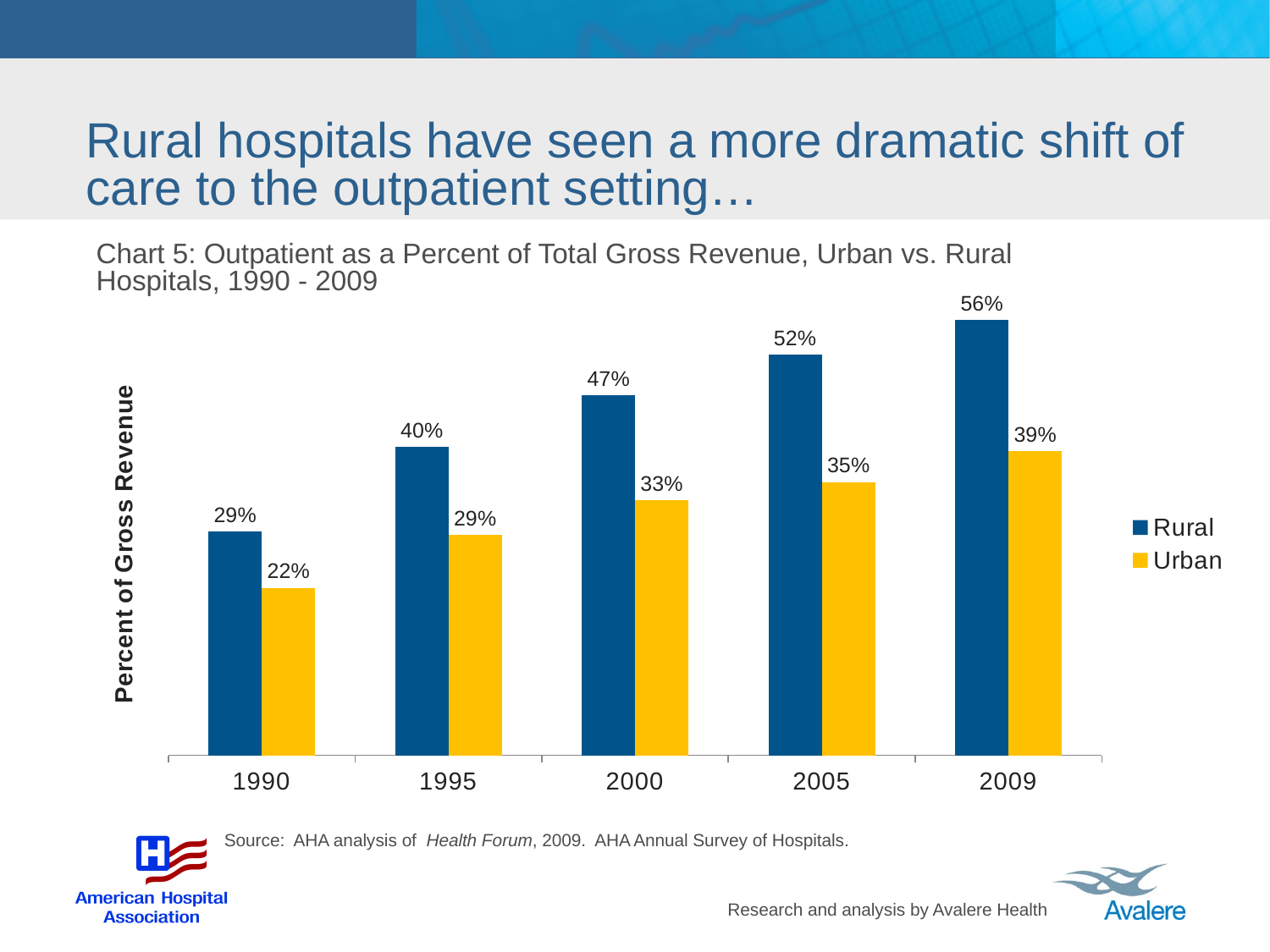
How many series does the legend list? 2 In which year was the Rural value highest? 2009 What is the difference between the Rural and Urban values in 2009? 17 percentage points What was the Rural value in 2009? 56% Which was larger in 2000, the Rural value or the Urban value? Rural By how many percentage points did the Rural value increase from 1990 to 2009? 27 percentage points In which year was the Urban value lowest? 1990 How many years are shown on the x axis? 5 What was the Urban value in 1990? 22% What kind of chart is shown? Bar chart What was the Urban value in 2005? 35% Do the Urban values rise or fall from 1990 to 2009? Rise